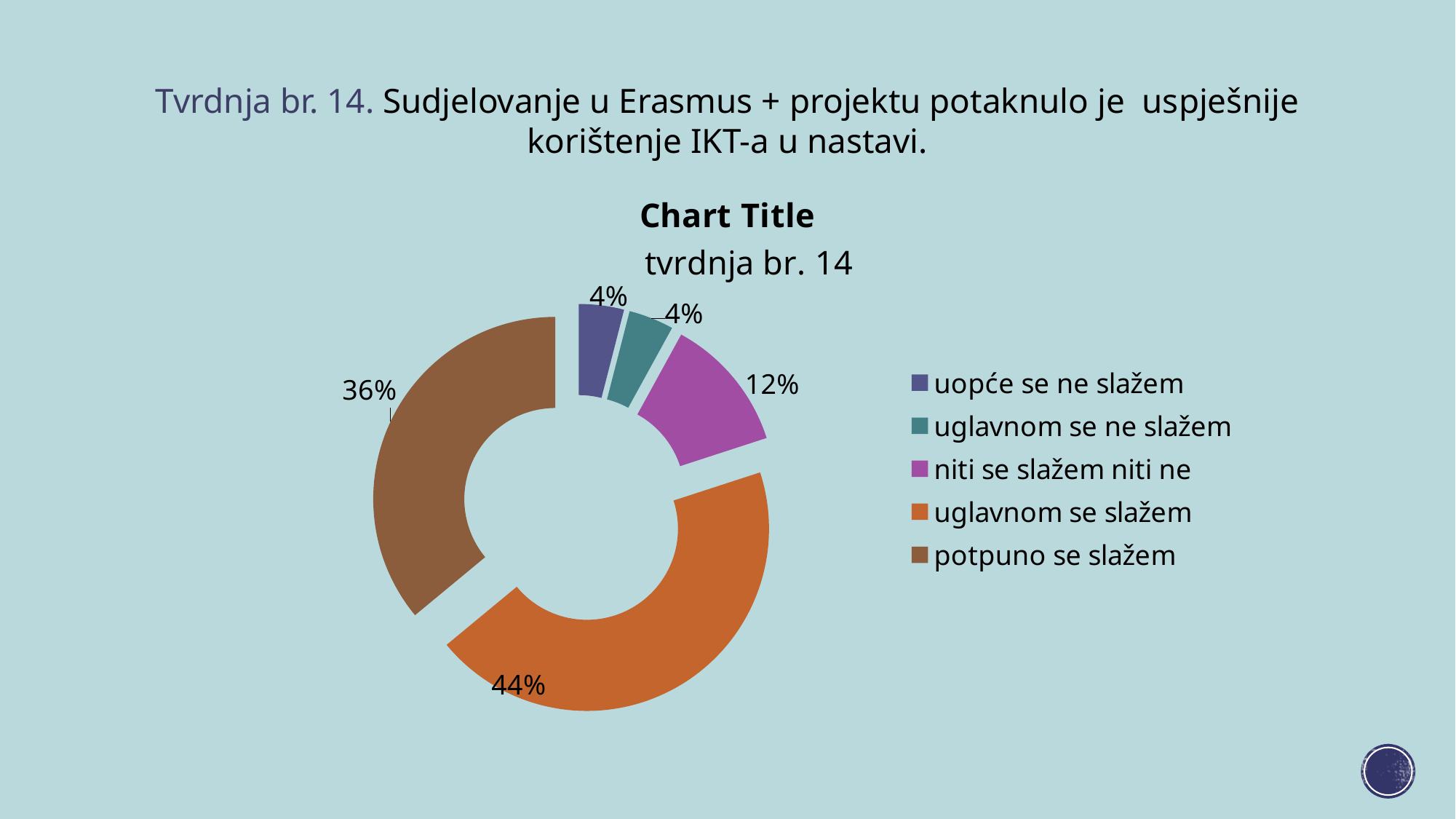
Which response category has the largest share: "potpuno se slažem" or "niti se slažem niti ne"? potpuno se slažem Which colour represents "uglavnom se slažem" in the legend? orange What percentage of respondents answered "potpuno se slažem"? 36% What is the combined share of "uglavnom se slažem" and "potpuno se slažem"? 80% How many response categories does the chart show? 5 What percentage of respondents answered "uopće se ne slažem"? 4% What kind of chart is shown on the slide? doughnut (pie) chart What is the difference in percentage points between "uglavnom se slažem" and "potpuno se slažem"? 8 What is the subtitle shown below "Chart Title" on the chart? tvrdnja br. 14 Which response category has the largest share of the chart? uglavnom se slažem What percentage of respondents answered "uglavnom se slažem"? 44% What percentage of respondents answered "niti se slažem niti ne"? 12%